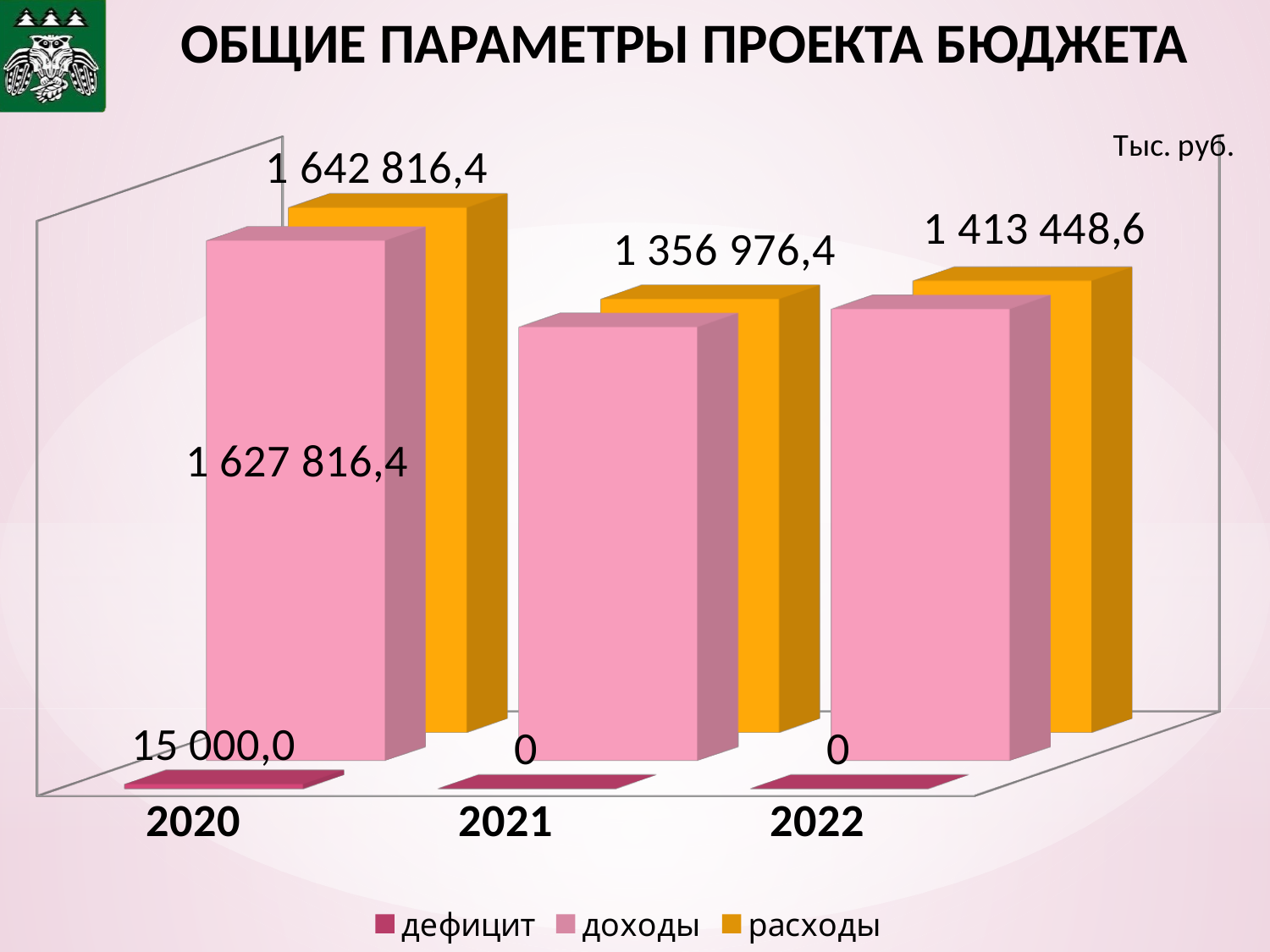
What is the value of расходы for 2022? 1 413 448,6 What is the value of дефицит for 2021? 0 What is the difference between расходы and доходы in 2020? 15 000,0 In which year is расходы the highest? 2020 How many series does the legend list? 3 What kind of chart is shown on the slide? Bar chart What is the value of доходы for 2020? 1 627 816,4 In which year is расходы the lowest? 2021 What is the value of расходы for 2020? 1 642 816,4 What is the value of дефицит for 2020? 15 000,0 How many years are shown on the x axis? 3 What is the value of расходы for 2021? 1 356 976,4